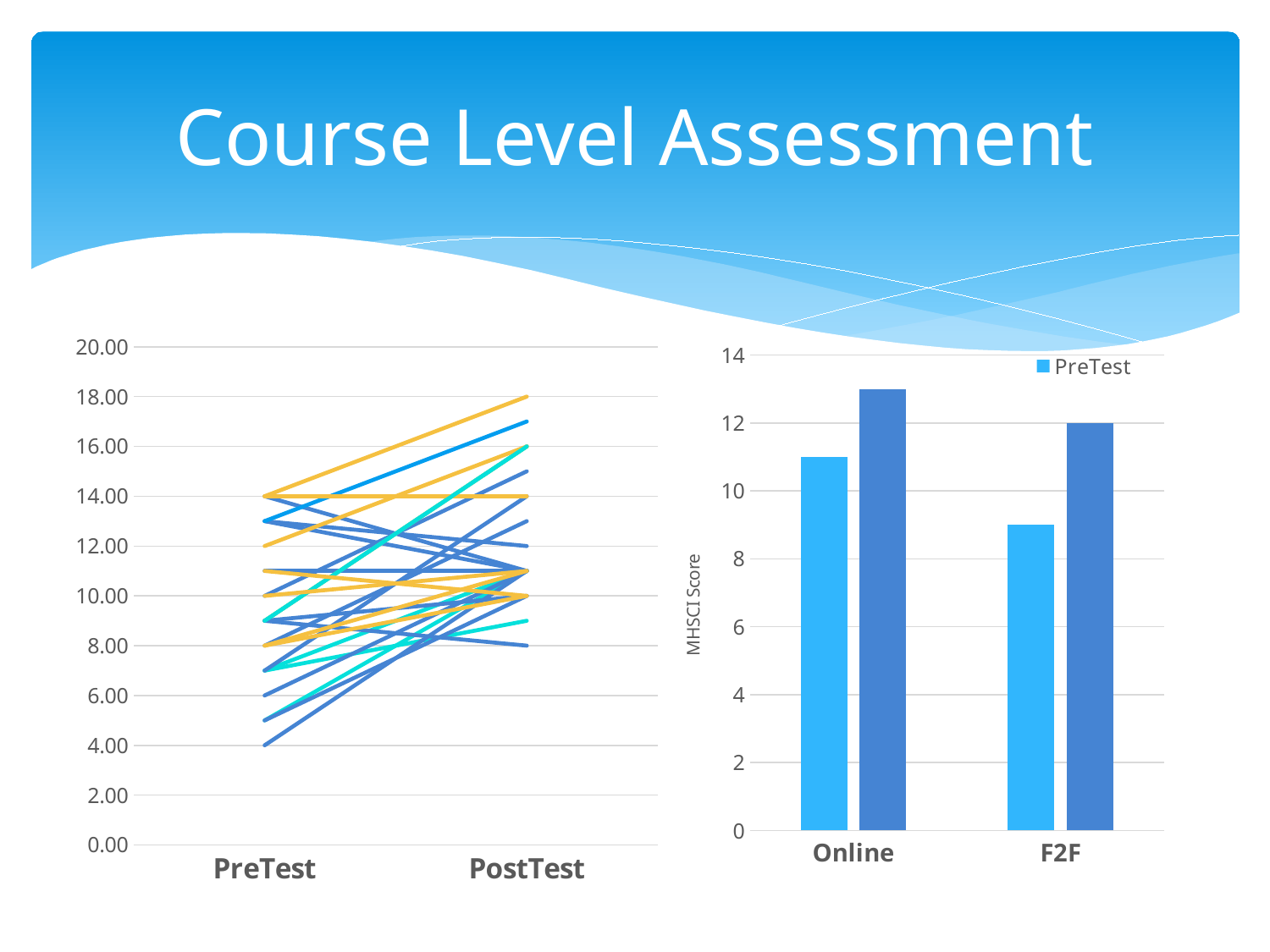
In the chart on the left, do most of the lines rise or fall from PreTest to PostTest? rise In the chart on the right, is the PreTest value for Online greater or less than 10? greater In the chart on the left, how many points are on the x axis? 2 In the chart on the right, what are the two categories on the x axis? Online and F2F In the chart on the right, which category has the higher PreTest value, Online or F2F? Online In the chart on the right, what is the label of the y axis? MHSCI Score In the chart on the right, for Online, is the PreTest bar taller or shorter than the darker blue bar next to it? shorter In the chart on the right, which category has the lowest PreTest value? F2F What kind of chart is the chart on the left side of the slide? line chart In the chart on the right, is the PreTest value for F2F greater or less than 10? less What kind of chart is the chart on the right side of the slide? bar chart In the chart on the right, how many categories are shown on the x axis? 2